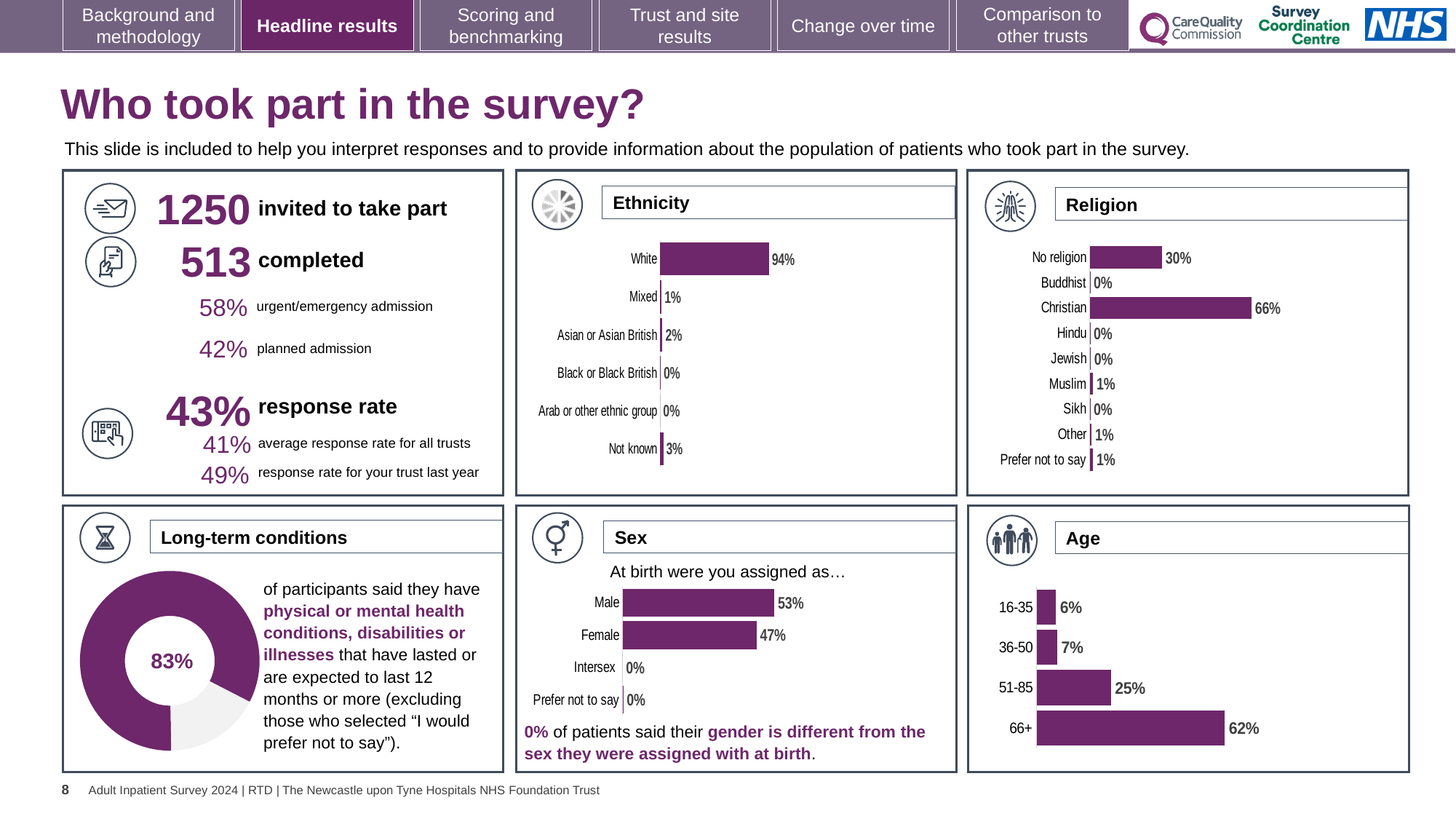
In the Sex chart, which is larger, Male or Female? Male What kind of chart is used in the Long-term conditions panel? Doughnut chart In the Age chart, what is the difference between the 66+ and 51-85 values? 37% In the Religion chart, which category has the highest value? Christian In the Religion chart, what is the value for No religion? 30% In the Ethnicity chart, what percentage of respondents are White? 94% In the Ethnicity chart, how many ethnicity categories are listed? 6 In the Long-term conditions chart, what share of participants said they have long-term conditions? 83% In the Ethnicity chart, what is the value for Not known? 3% In the Sex chart, what is the value for Female? 47% In the Age chart, do the values rise or fall as age increases from 16-35 to 66+? Rise In the Age chart, how many age categories are shown? 4